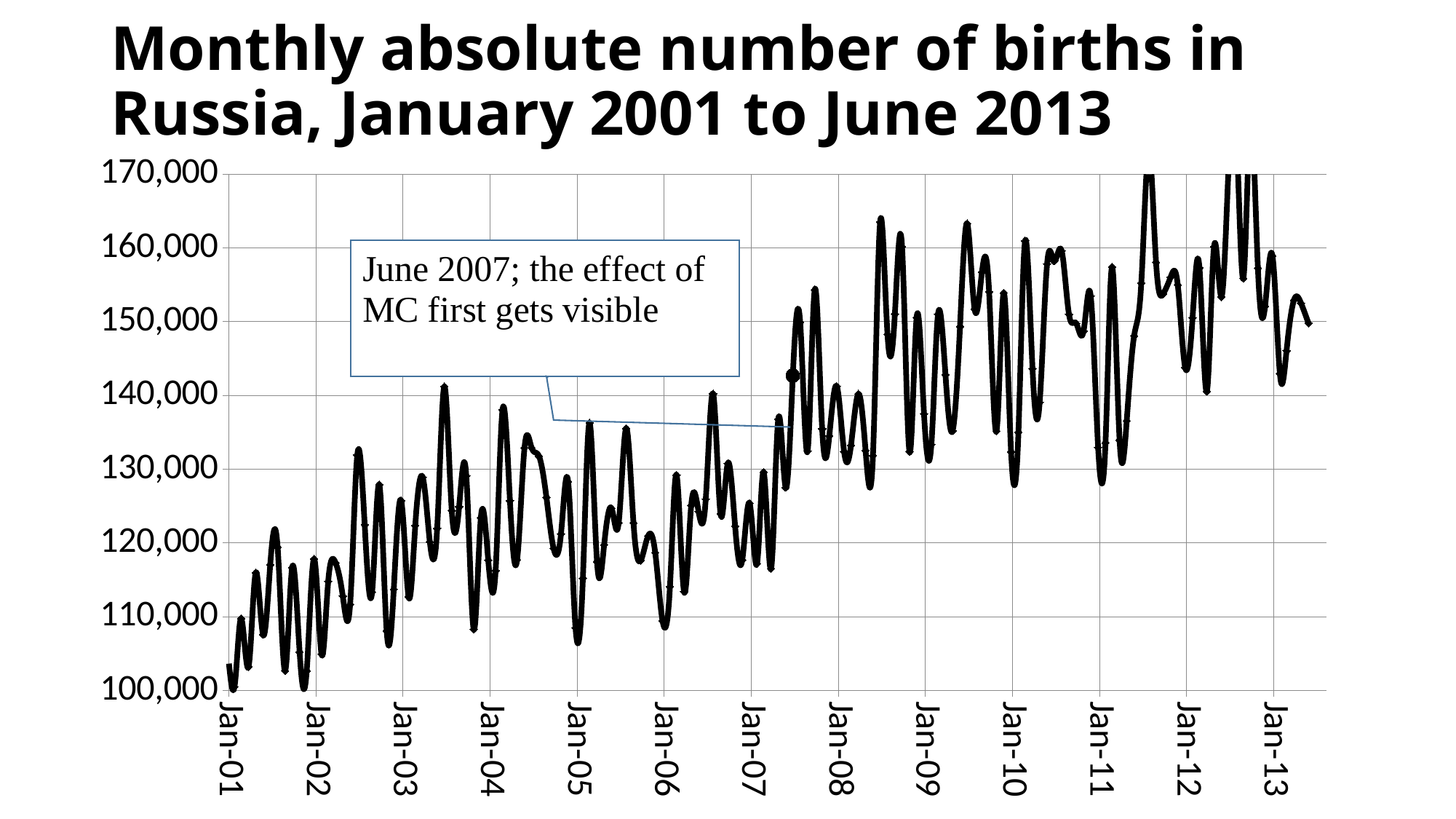
Is the value for Jan-12 greater or less than 130,000? greater Overall, do the monthly birth numbers rise or fall from January 2001 to June 2013? Rise Is the value for Jan-06 greater or less than 120,000? less Is the value for Jan-01 greater or less than 110,000? less Which is larger, the value at Jan-01 or the value at Jan-13? Jan-13 What does the annotation box on the chart say? June 2007; the effect of MC first gets visible How many year labels are shown on the x axis? 13 What is the highest value shown on the y axis? 170,000 What kind of chart is shown on the slide? Line chart What is the title of the chart? Monthly absolute number of births in Russia, January 2001 to June 2013